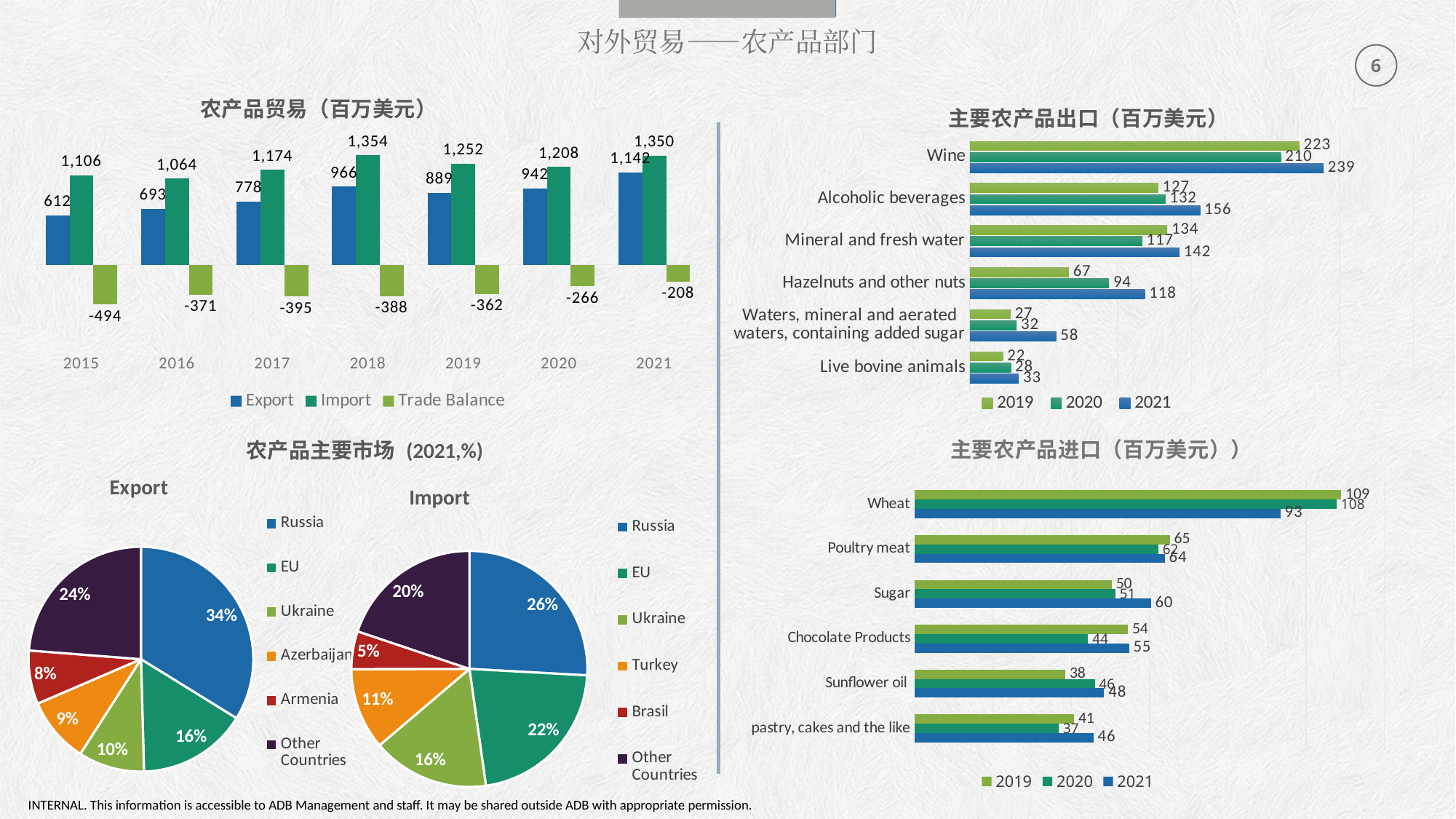
In the top-right chart titled 主要农产品出口（百万美元）, how many product categories are shown? 6 In the top-left chart titled 农产品贸易（百万美元）, which year has the highest Export value? 2021 In the top-right chart titled 主要农产品出口（百万美元）, what is the 2021 value for Wine? 239 In the bottom-right chart titled 主要农产品进口（百万美元）, which is larger for Sugar: the 2019 value or the 2021 value? 2021 In the top-left chart titled 农产品贸易（百万美元）, what is the Import value for 2018? 1,354 In the bottom-right chart titled 主要农产品进口（百万美元）, what is the 2020 value for Chocolate Products? 44 In the top-left chart titled 农产品贸易（百万美元）, what is the difference between Import and Export in 2015? 494 In the top-left chart titled 农产品贸易（百万美元）, how many series does the legend list? 3 In the top-right chart titled 主要农产品出口（百万美元）, which category has the lowest 2019 value? Live bovine animals In the top-left chart titled 农产品贸易（百万美元）, does the Export value rise or fall from 2015 to 2018? rise In the Export pie chart under 农产品主要市场（2021,%）, what share does Russia have? 34% What kind of chart is the Import chart under 农产品主要市场（2021,%）? pie chart